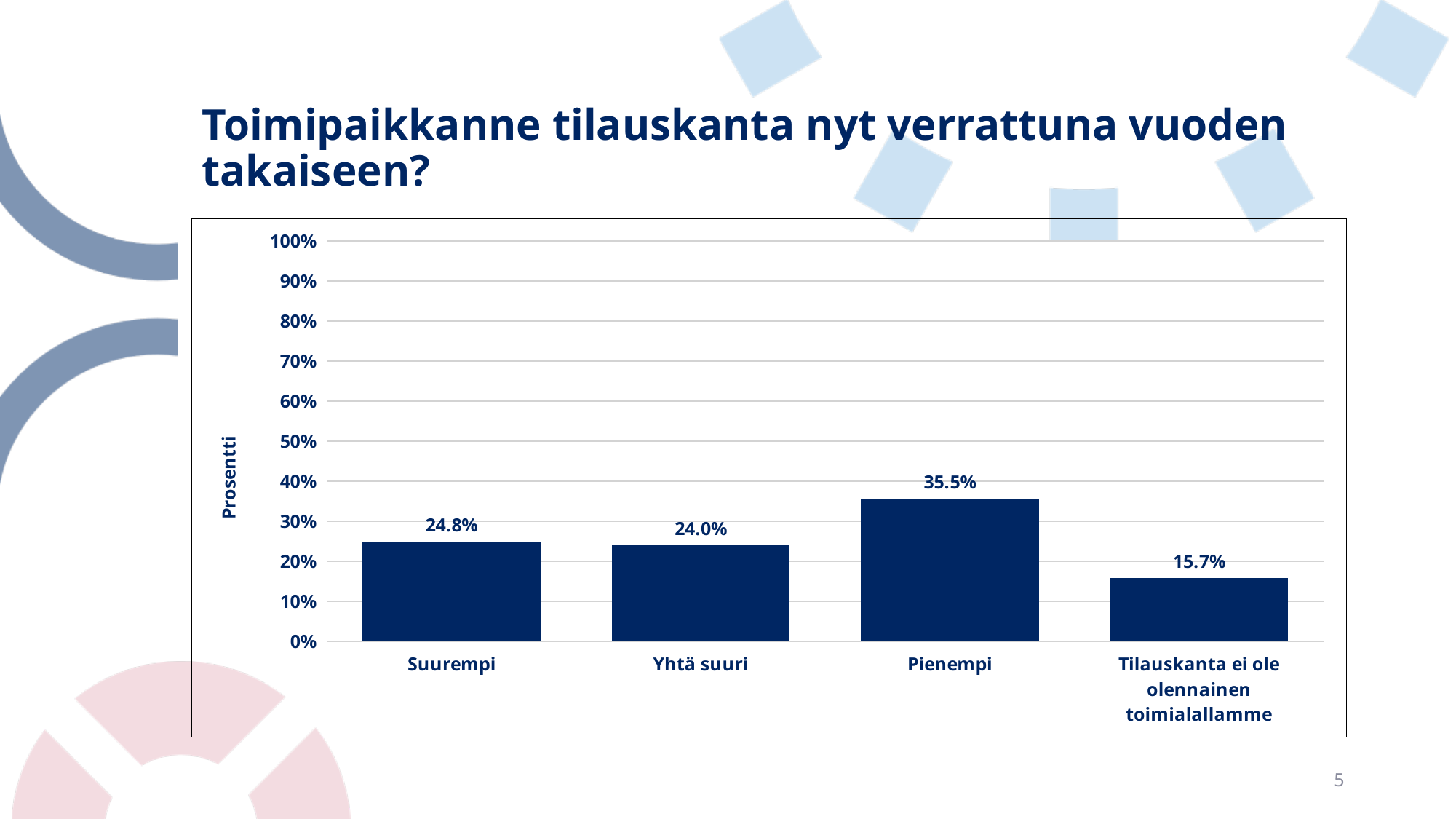
What is the value for Yhtä suuri? 24.0% What is the value for Tilauskanta ei ole olennainen toimialallamme? 15.7% What kind of chart is shown on the slide? Bar chart Which category has the lowest value? Tilauskanta ei ole olennainen toimialallamme What is the value for Suurempi? 24.8% What is the value for Pienempi? 35.5% What is the difference between the values for Yhtä suuri and Tilauskanta ei ole olennainen toimialallamme? 8.3% How many categories are shown on the x axis? 4 Which category has the highest value? Pienempi Is the value for Pienempi greater or less than 30%? greater Which is larger, the value for Pienempi or the value for Yhtä suuri? Pienempi What is the difference between the values for Pienempi and Suurempi? 10.7%